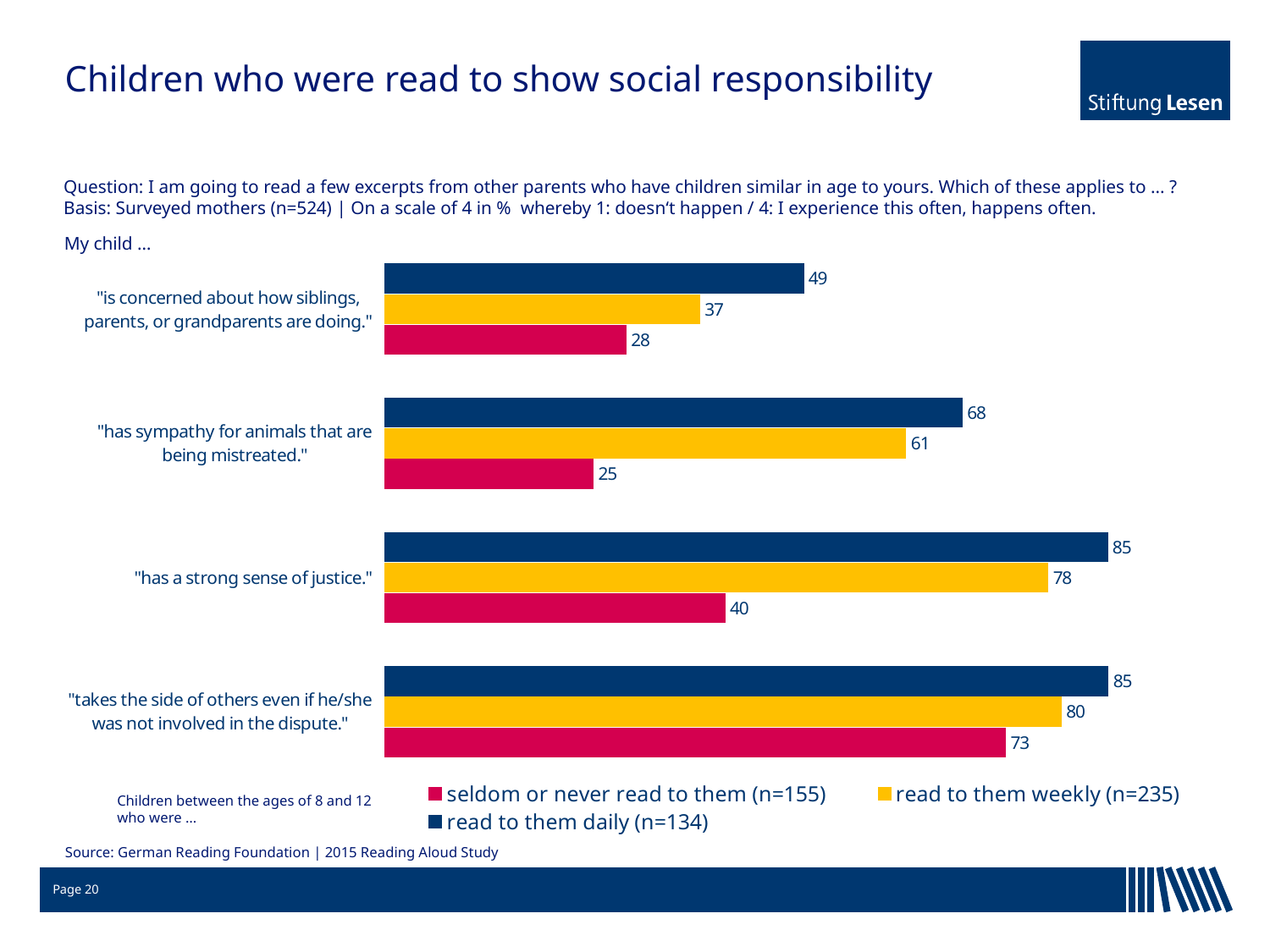
How many statements (categories) are shown in the chart? 4 What is the difference between the daily and seldom-or-never values for "has a strong sense of justice"? 45 Which statement has the lowest value among children who were read to daily? "is concerned about how siblings, parents, or grandparents are doing." What value is shown for "has a strong sense of justice" among children who were read to daily? 85 What value is shown for "is concerned about how siblings, parents, or grandparents are doing" among children who were read to weekly? 37 How many series does the legend list? 3 What is the difference between the weekly and seldom-or-never values for "has sympathy for animals that are being mistreated"? 36 For "takes the side of others even if he/she was not involved in the dispute", which is larger: the value for read to them weekly or the value for seldom or never read to them? read to them weekly What value is shown for "has sympathy for animals that are being mistreated" among children who were seldom or never read to? 25 What value is shown for "takes the side of others even if he/she was not involved in the dispute" among children who were seldom or never read to? 73 What kind of chart is shown on the slide? bar chart Which statement has the lowest value among children who were seldom or never read to? "has sympathy for animals that are being mistreated."